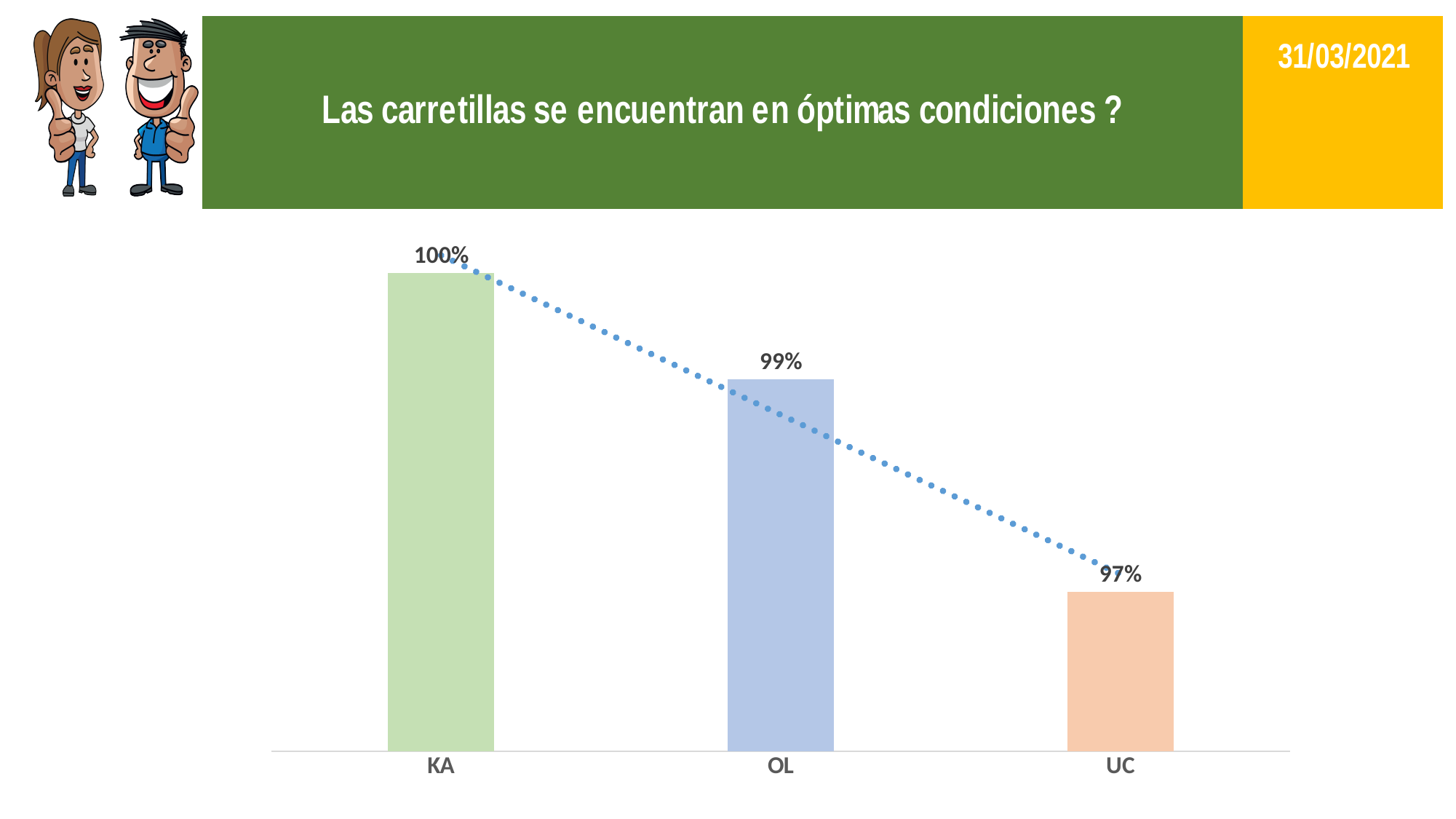
Which category has the lowest value? UC What is the difference between the values for OL and UC? 2% How many categories are shown on the x axis? 3 What is the title shown above the chart? Las carretillas se encuentran en óptimas condiciones ? What is the value for OL? 99% What is the value for KA? 100% What is the value for UC? 97% What is the difference between the values for KA and UC? 3% Which category has the highest value? KA Which is larger, the value for KA or the value for UC? KA What kind of chart is shown on the slide? bar chart Do the values rise or fall from KA to UC along the x axis? fall